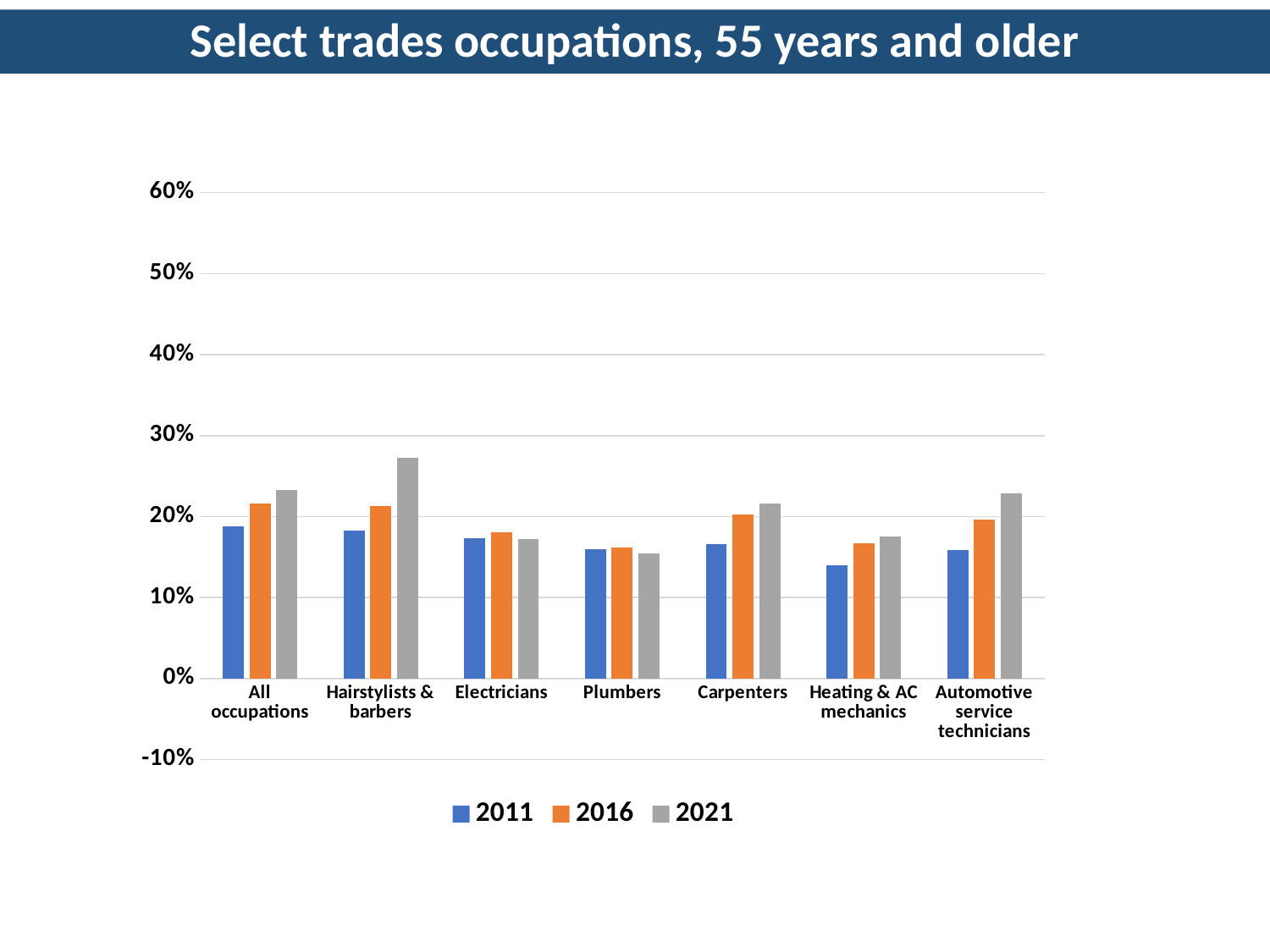
Is the 2011 value for Heating & AC mechanics greater or less than 20%? less How many series does the legend list? 3 Is the 2021 value for Hairstylists & barbers greater or less than 20%? greater What kind of chart is shown on the slide? Bar chart Which is larger: the 2016 value for Carpenters or the 2016 value for Electricians? Carpenters Which occupation has the highest value for 2021? Hairstylists & barbers Which is larger: the 2021 value for Automotive service technicians or the 2021 value for Plumbers? Automotive service technicians Do the values for Carpenters rise or fall from 2011 to 2021? rise Which occupation has the lowest value for 2011? Heating & AC mechanics What are the three entries in the legend? 2011, 2016, 2021 Do the values for Hairstylists & barbers rise or fall from 2011 to 2021? rise How many occupation categories are shown on the x axis? 7